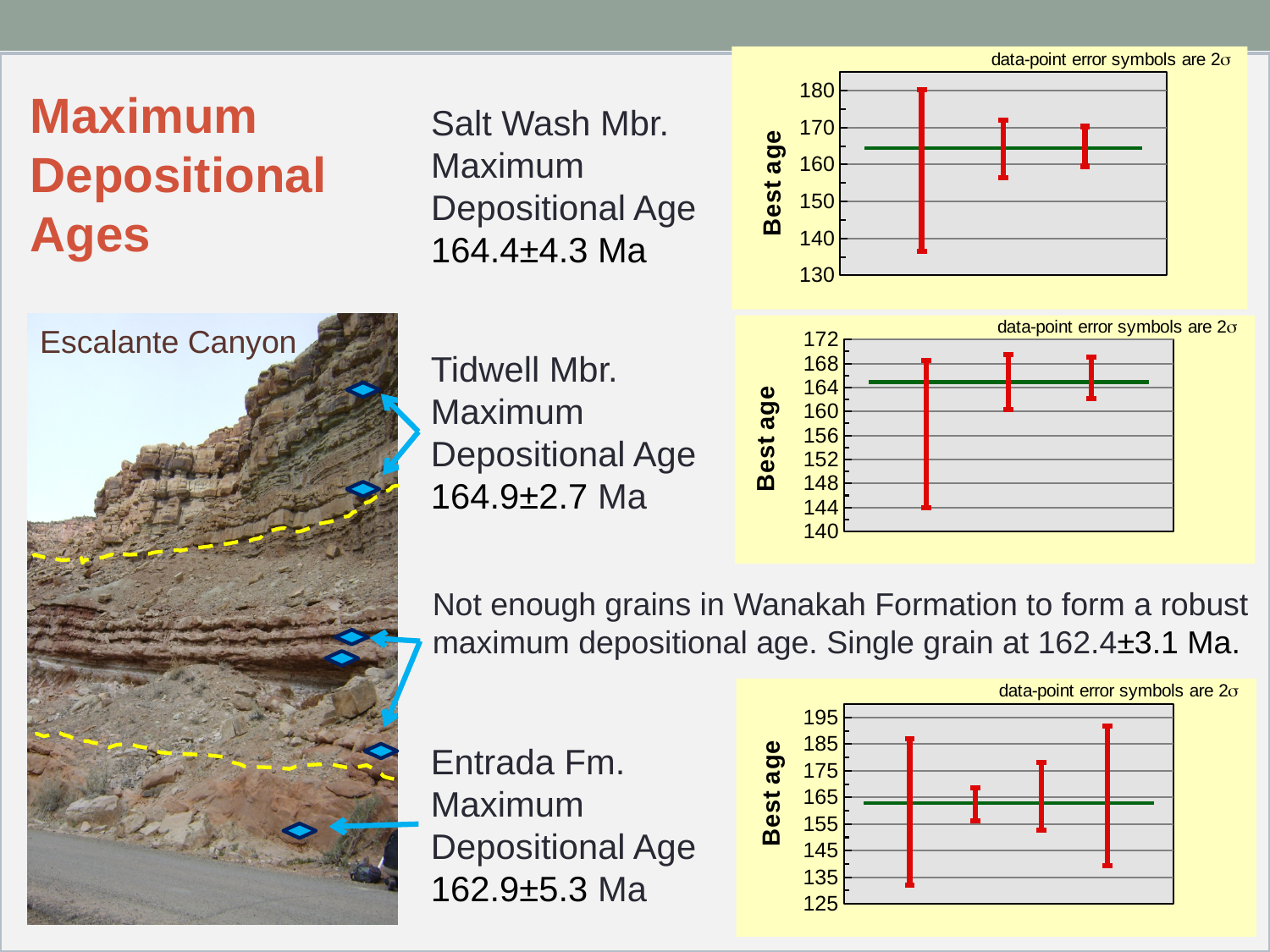
How many charts are shown on the slide? 3 What is the highest y-axis tick value on the bottom chart (Entrada Fm.)? 195 According to the note above each chart, what confidence level do the data-point error symbols represent? 2σ In the bottom chart (Entrada Fm.), how many red error bars are plotted? 4 In the middle chart (Tidwell Mbr.), is the bottom of the first (leftmost) error bar greater or less than 148? less In the bottom chart (Entrada Fm.), is the top of the fourth (rightmost) error bar greater or less than 185? greater What is the y-axis label on the top chart? Best age In the top chart (Salt Wash Mbr.), is the green horizontal line greater or less than 170? less In the top chart (Salt Wash Mbr.), how many red error bars are plotted? 3 What is the lowest y-axis tick value on the middle chart (Tidwell Mbr.)? 140